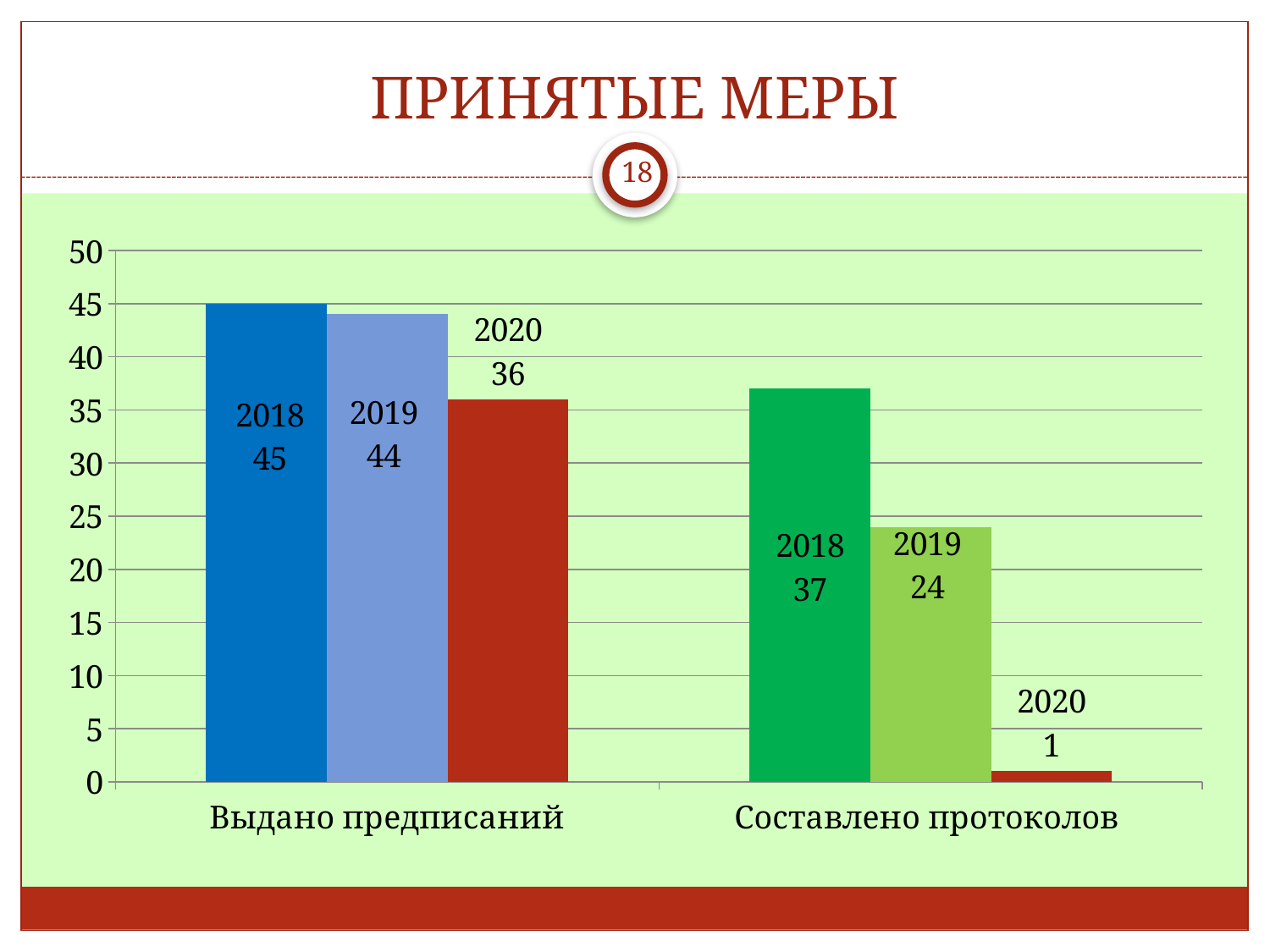
Which year has the lowest value in the "Выдано предписаний" group? 2020 What value is shown for 2018 in the "Составлено протоколов" group? 37 What value is shown for 2018 in the "Выдано предписаний" group? 45 What kind of chart is shown on the slide? Bar chart Which is larger: the 2019 value for "Выдано предписаний" or the 2019 value for "Составлено протоколов"? Выдано предписаний What value is shown for 2020 in the "Составлено протоколов" group? 1 What is the difference between the 2018 and 2020 values in the "Выдано предписаний" group? 9 What value is shown for 2019 in the "Выдано предписаний" group? 44 Which year has the highest value in the "Составлено протоколов" group? 2018 What is the difference between the 2019 and 2020 values in the "Составлено протоколов" group? 23 How many category groups are shown on the x axis? 2 Do the values in the "Составлено протоколов" group rise or fall from 2018 to 2020? Fall